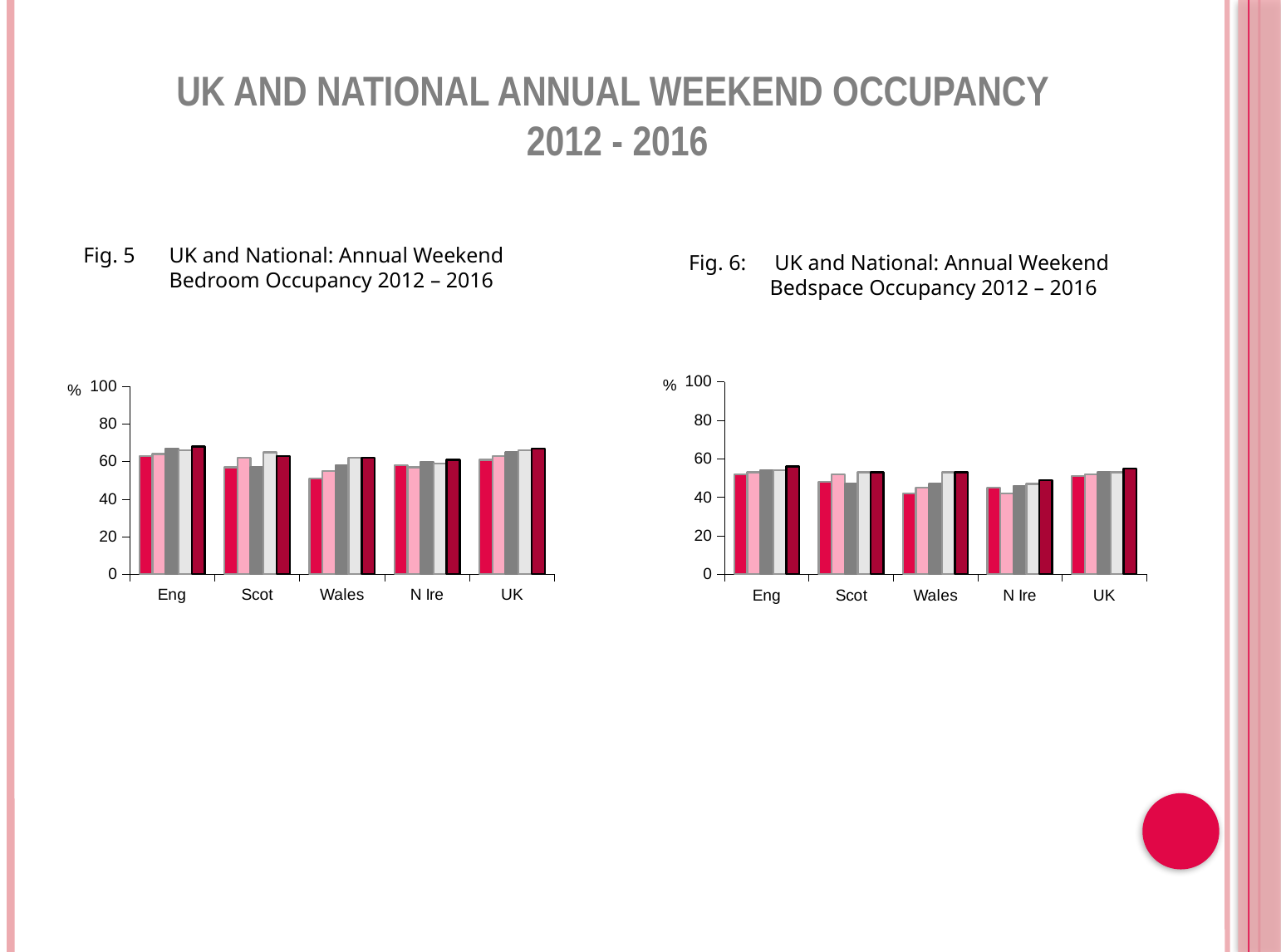
In Fig. 5, is the value of the first (leftmost) bar for Wales greater or less than 60? less How many categories are shown on the x axis of Fig. 6? 5 What unit is shown on the y axis of Fig. 6? % In Fig. 6, which is larger: the last bar for Eng or the last bar for Wales? Eng In Fig. 5, is the value of the last (rightmost) bar for Eng greater or less than 60? greater What kind of chart is Fig. 5? bar chart In Fig. 5, which is larger: the first bar for Eng or the first bar for Wales? Eng In Fig. 6, do the bars for UK rise or fall from left to right? rise In Fig. 5, do the bars for UK rise or fall from left to right? rise In Fig. 6, is the value of the first (leftmost) bar for Wales greater or less than 60? less In Fig. 5, which category has the lowest single bar? Wales